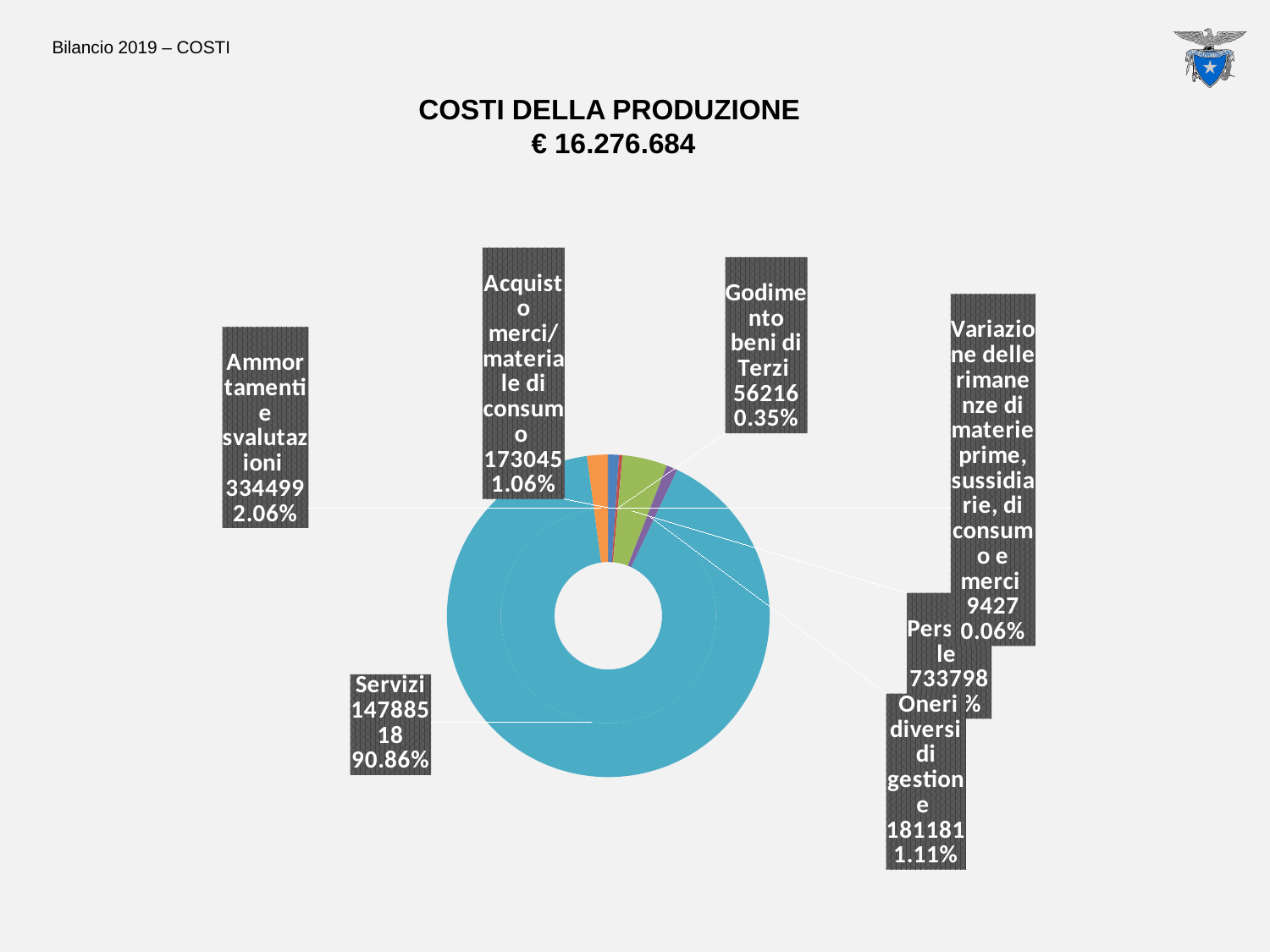
What percentage share does Servizi have? 90.86% What is the title of the chart? COSTI DELLA PRODUZIONE € 16.276.684 What is the value shown for Servizi? 14788518 Which category has the largest share of the chart? Servizi What kind of chart is shown on the slide? doughnut (pie) chart What is the difference between the values for Ammortamenti e svalutazioni and Oneri diversi di gestione? 153318 Which category has the smallest share of the chart? Variazione delle rimanenze di materie prime, sussidiarie, di consumo e merci Which is larger, Oneri diversi di gestione or Acquisto merci/materiale di consumo? Oneri diversi di gestione What percentage share does Acquisto merci/materiale di consumo have? 1.06% What is the value shown for Ammortamenti e svalutazioni? 334499 What is the value shown for Godimento beni di Terzi? 56216 How many categories are shown in the chart? 7